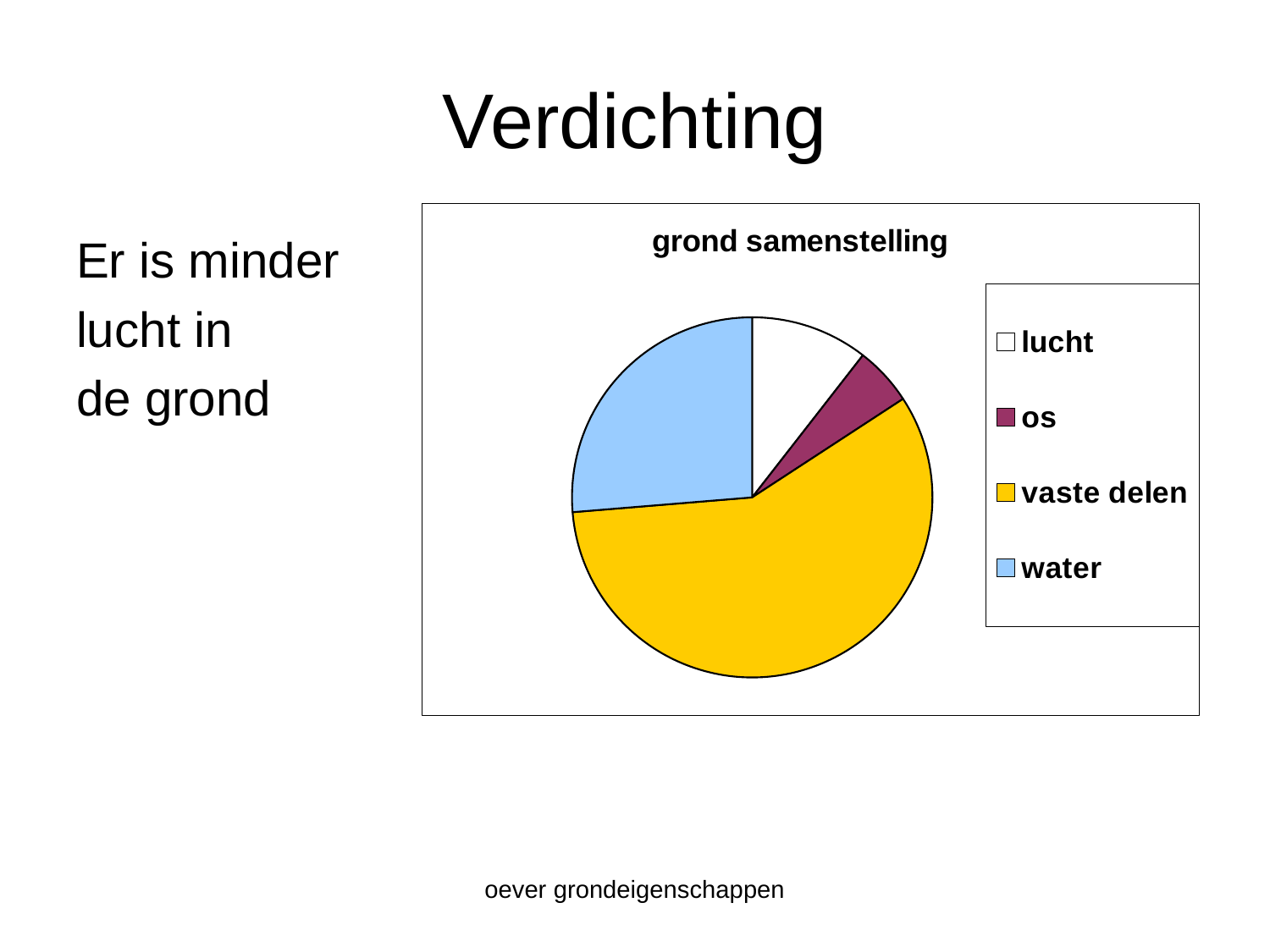
What is the title of the chart? grond samenstelling Which category has the smallest slice of the pie? os What kind of chart is shown on the slide? pie chart Which slice is larger, lucht or os? lucht Which slice is larger, vaste delen or water? vaste delen How many slices does the pie chart have? 4 Which slice is larger, water or lucht? water Which category has the largest slice of the pie? vaste delen What colour is the slice for water? light blue How many entries does the legend list? 4